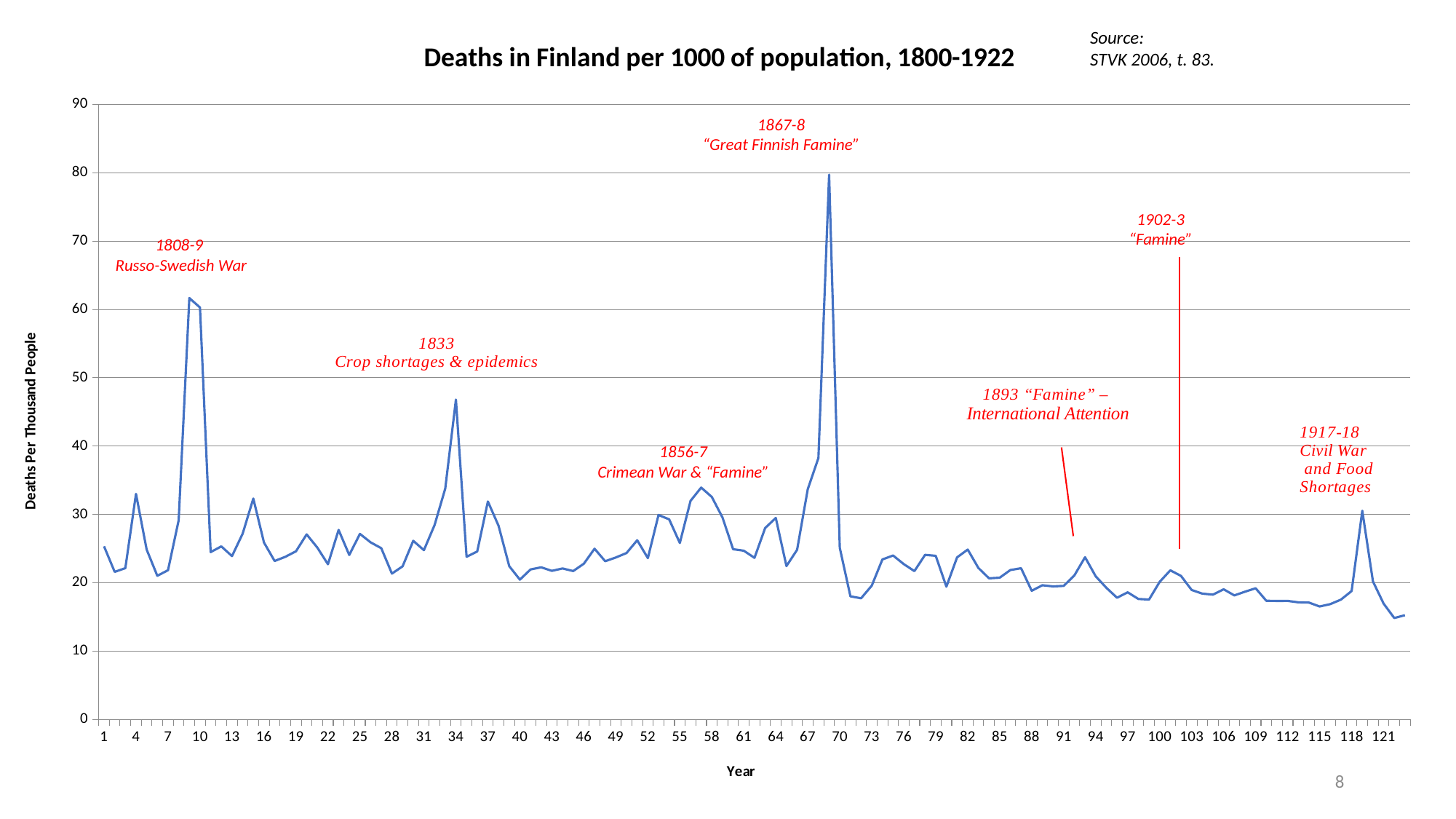
What is the title of the chart? Deaths in Finland per 1000 of population, 1800-1922 Is the value at year index 119 greater or less than 20? greater What is the label of the vertical axis? Deaths Per Thousand People What kind of chart is shown on the slide? line chart Is the value at year index 9 greater or less than 50? greater At which year index on the x axis does the line reach its highest value? 69 Is the value at year index 34 greater or less than 40? greater Which is larger, the value at year index 9 or the value at year index 34? year index 9 How many data series are plotted on the chart? 1 Which is larger, the value at year index 69 or the value at year index 9? year index 69